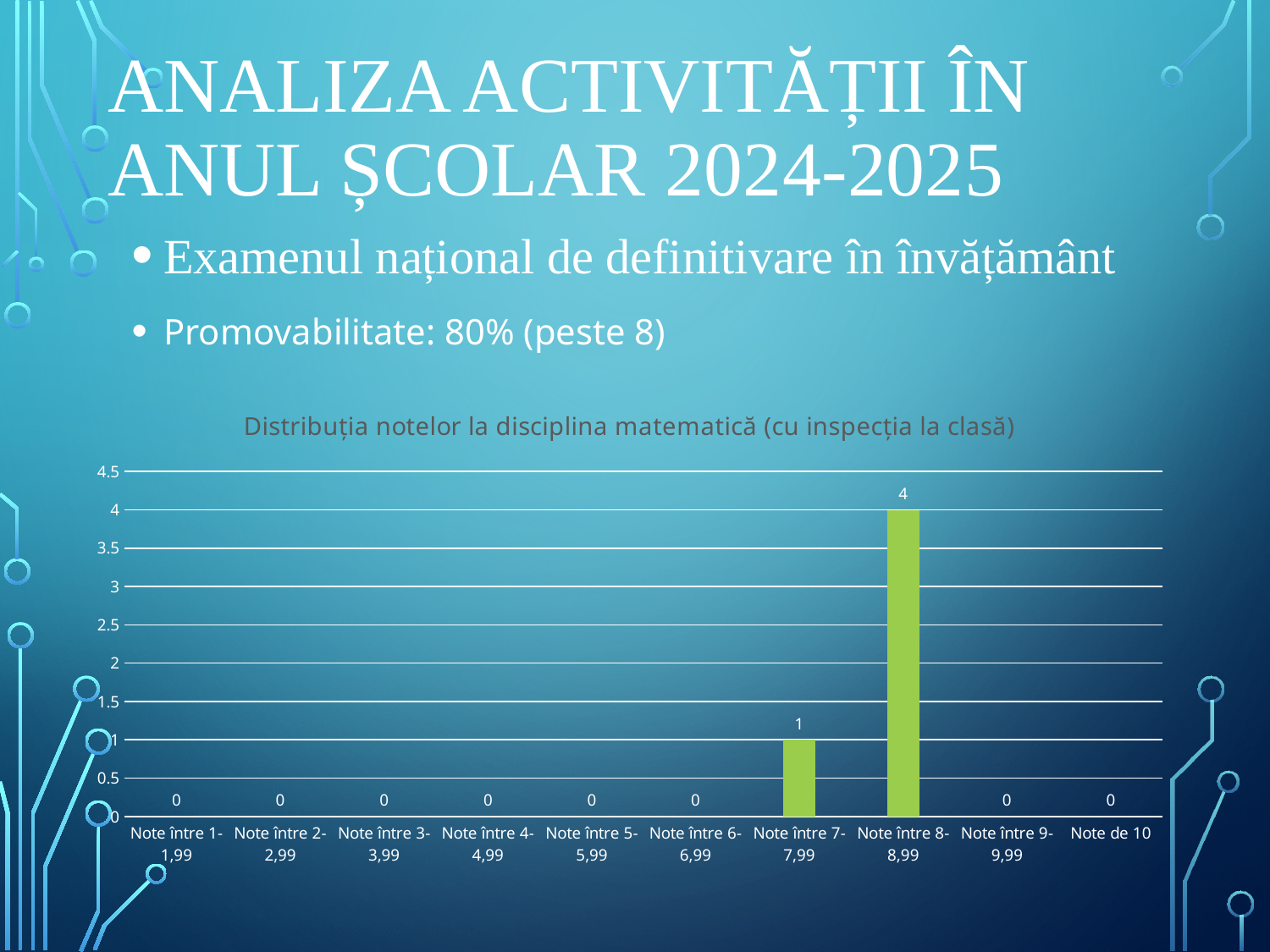
What is the value for 'Note de 10'? 0 What is the highest value shown on the y axis? 4.5 What is the title of the chart? Distribuția notelor la disciplina matematică (cu inspecția la clasă) What kind of chart is shown on the slide? bar chart What is the value for 'Note între 8-8,99'? 4 How many categories are shown on the x axis? 10 How many categories have a value of 0? 8 Which category has the highest value? Note între 8-8,99 Is the value for 'Note între 8-8,99' greater or less than 3? greater What is the value for 'Note între 7-7,99'? 1 What is the difference between the values for 'Note între 8-8,99' and 'Note între 7-7,99'? 3 Which is larger, the value for 'Note între 7-7,99' or the value for 'Note între 8-8,99'? Note între 8-8,99